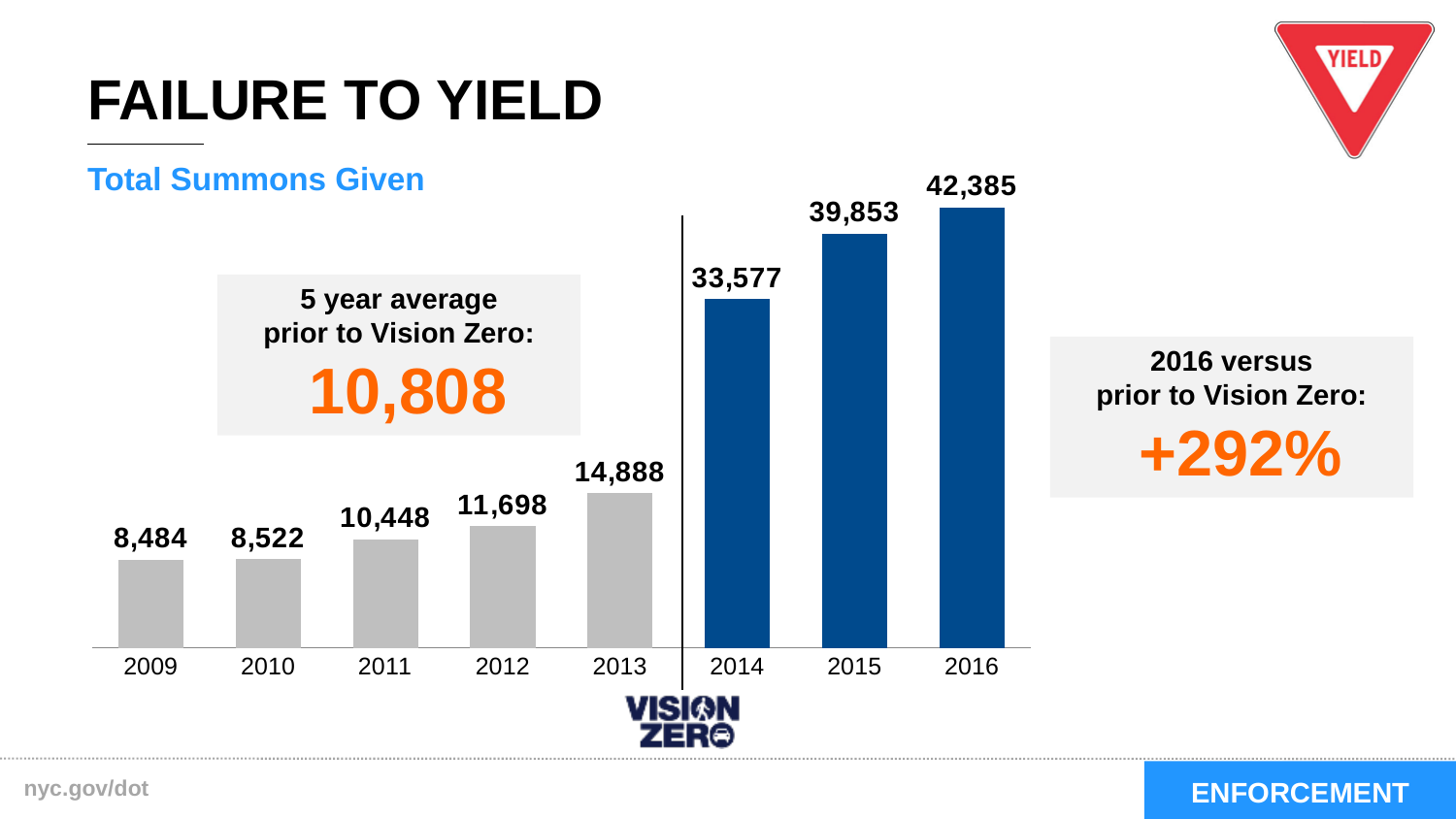
By how much did the value increase from 2013 to 2014? 18,689 What is the 5 year average prior to Vision Zero shown on the slide? 10,808 How many years are shown on the x axis of the chart? 8 What is the difference between the 2016 and 2015 values? 2,532 Which year has the highest number of total summons given? 2016 Which is larger, the value for 2009 or the value for 2010? 2010 What kind of chart is used to show Total Summons Given? Bar chart How many summons were given in 2011 according to the chart? 10,448 Do the values rise or fall from 2009 to 2016? Rise Which year has the lowest number of total summons given? 2009 What is the value for 2014 in the Total Summons Given chart? 33,577 What is the value shown for 2016? 42,385